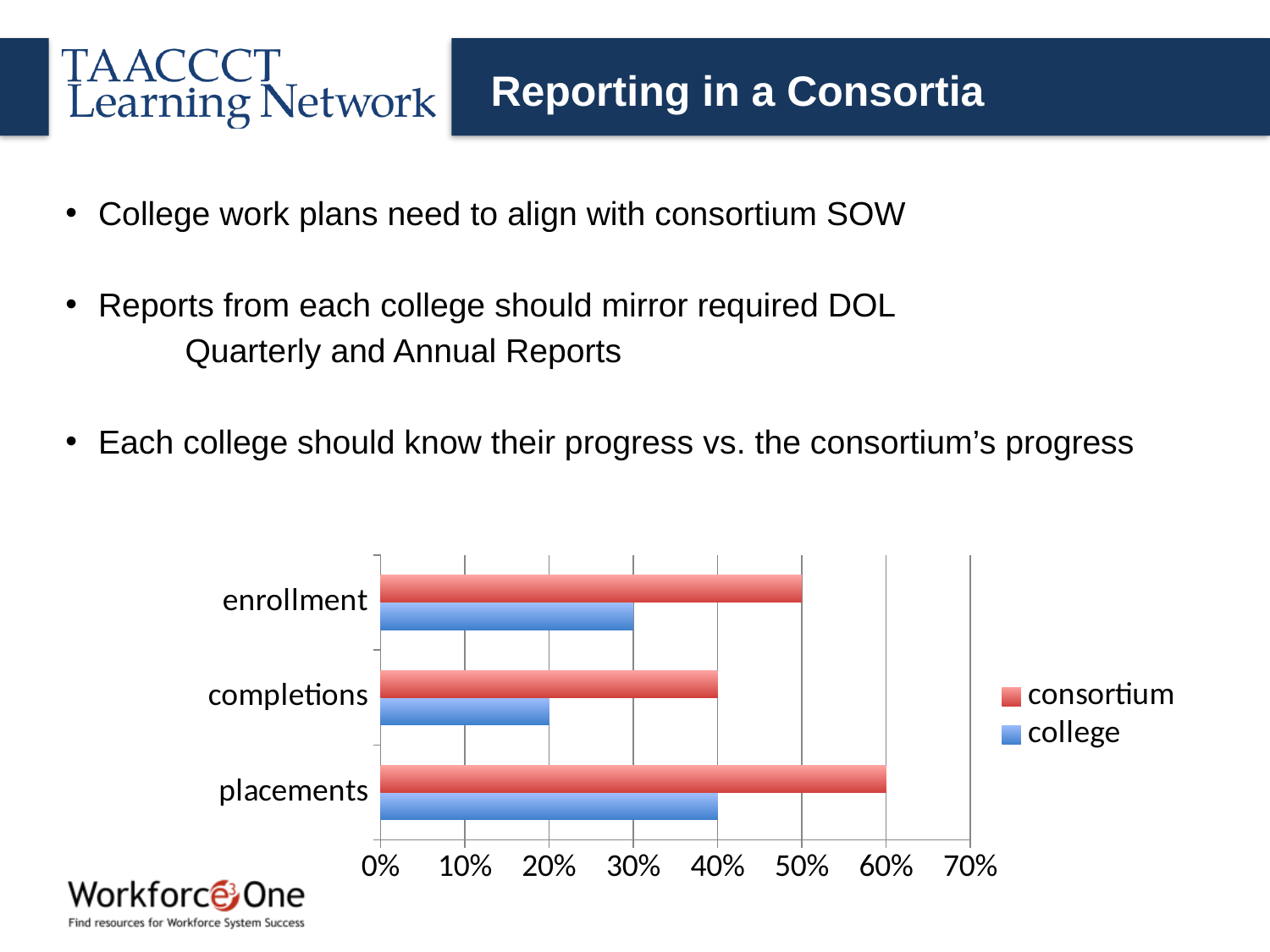
How many series does the chart legend list? 2 Which category has the lowest college value? completions Which category has the highest consortium value? placements What is the consortium value for enrollment? 50% What is the difference between the consortium and college values for enrollment? 20% Which series is shown in red on the chart? consortium What is the consortium value for placements? 60% What kind of chart is shown on the slide? bar chart What is the college value for placements? 40% What is the college value for completions? 20% Which is larger for completions, the consortium value or the college value? consortium How many categories are shown on the chart? 3